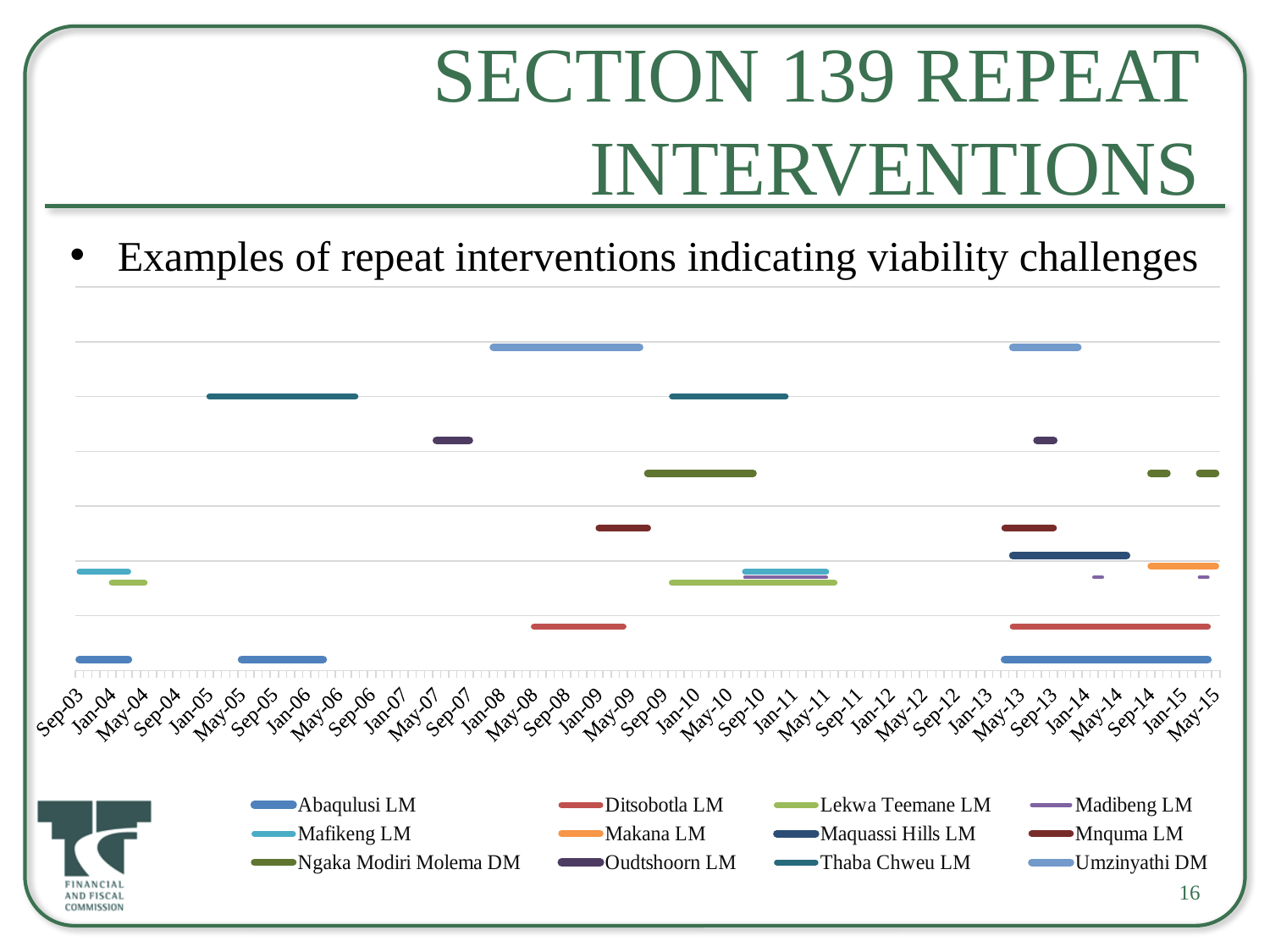
What is the last date label on the x axis? May-15 Does the Makana LM segment fall before or after Jan-13? after How many separate intervention segments are plotted for Maquassi Hills LM? 1 Does the first Umzinyathi DM segment fall before or after Jan-12? before How many separate intervention segments are plotted for Abaqulusi LM? 3 Which starts earlier, the first Thaba Chweu LM segment or the first Umzinyathi DM segment? Thaba Chweu LM What is the first date label on the x axis? Sep-03 Which starts earlier, the first Mnquma LM segment or the Makana LM segment? Mnquma LM How many series does the legend list? 12 How many separate intervention segments are plotted for Makana LM? 1 Does the first Ditsobotla LM segment fall before or after Jan-10? before